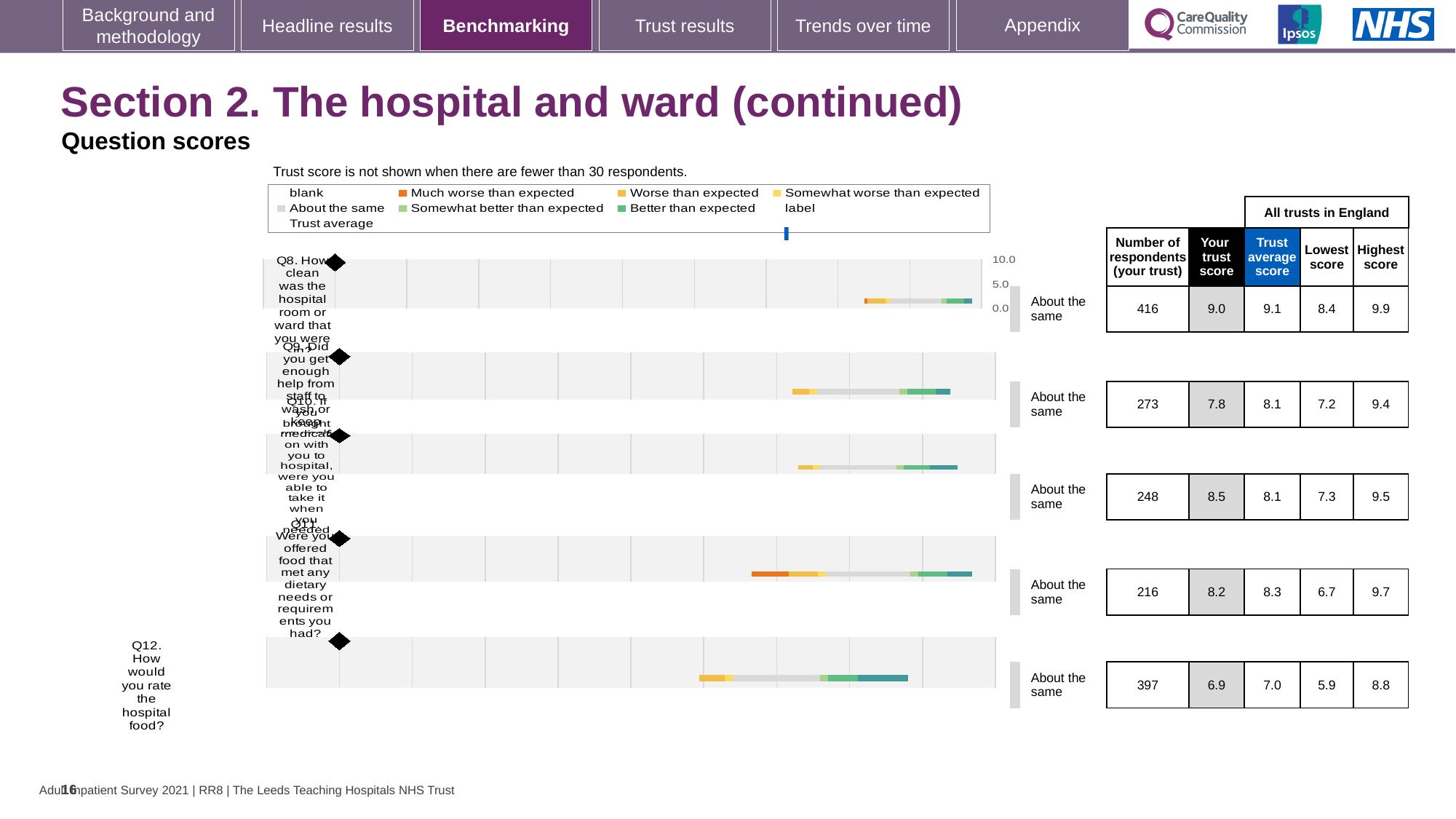
What benchmark category is shown for Q12? About the same What is the trust score for Q8 (How clean was the hospital room or ward)? 9.0 How many questions (Q8 to Q12) are plotted in the chart? 5 Which question has the highest trust score? Q8 Which question has the fewest respondents? Q11 What is the difference between the highest score and the lowest score for Q11? 3.0 What kind of chart is used to show the question scores on this slide? bar chart What is the trust average score for Q9 (Did you get enough help from staff to wash or keep yourself clean)? 8.1 What is the number of respondents for Q12 (How would you rate the hospital food)? 397 Which is larger for Q10: the trust score or the trust average score? trust score What is the lowest score across all trusts in England for Q12? 5.9 Which question has the lowest trust score? Q12